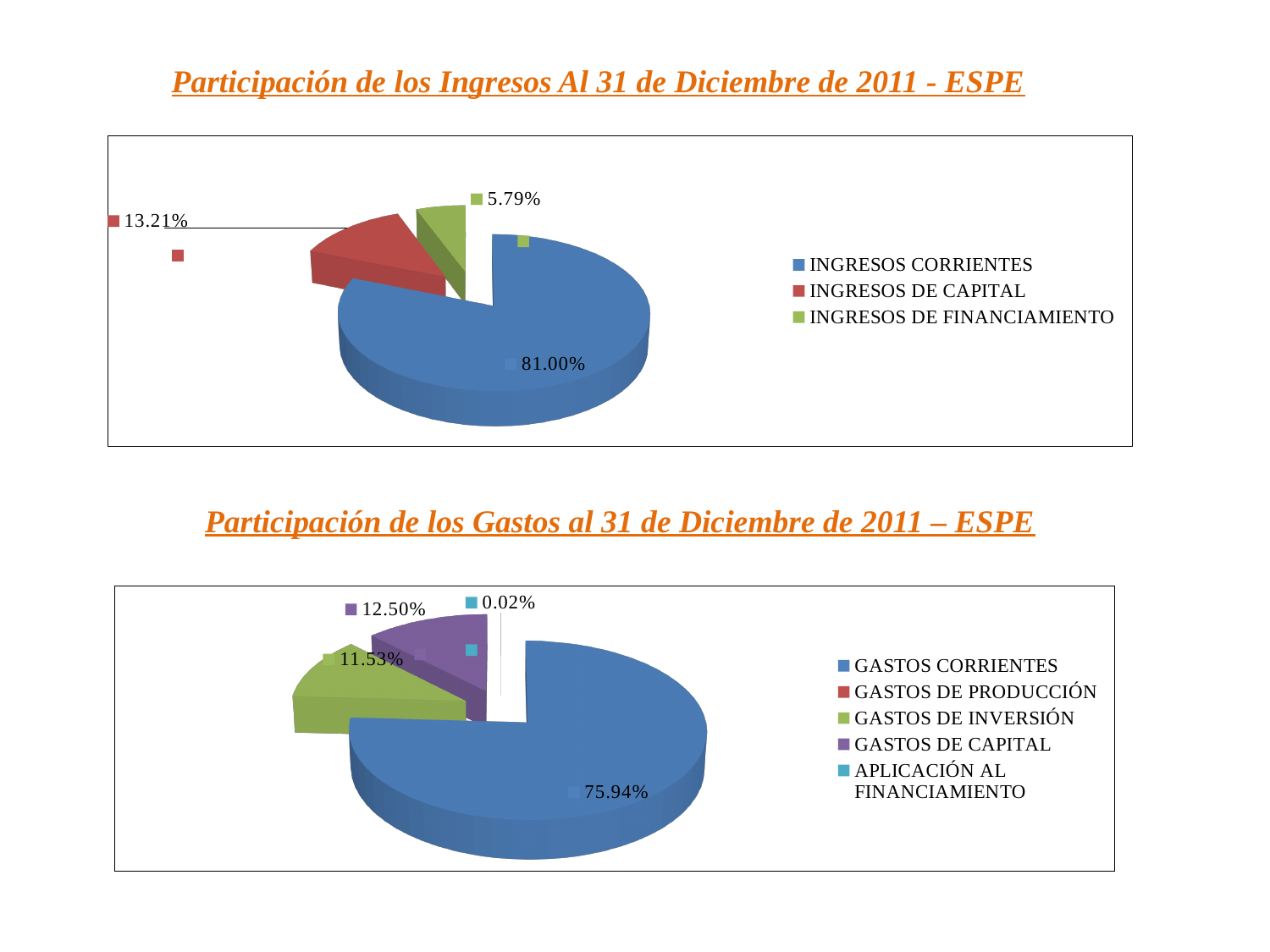
In the chart titled 'Participación de los Ingresos Al 31 de Diciembre de 2011 - ESPE', what share does INGRESOS DE CAPITAL have? 13.21% In the bottom chart (Gastos), which is larger: GASTOS DE CAPITAL or GASTOS DE INVERSIÓN? GASTOS DE CAPITAL In the chart titled 'Participación de los Gastos al 31 de Diciembre de 2011 – ESPE', what share does GASTOS CORRIENTES have? 75.94% In the chart titled 'Participación de los Gastos al 31 de Diciembre de 2011 – ESPE', what share does APLICACIÓN AL FINANCIAMIENTO have? 0.02% What kind of chart is the chart titled 'Participación de los Gastos al 31 de Diciembre de 2011 – ESPE'? Pie chart In the chart titled 'Participación de los Gastos al 31 de Diciembre de 2011 – ESPE', what share does GASTOS DE CAPITAL have? 12.50% How many categories does the legend of the top chart (Ingresos) list? 3 In the top chart (Ingresos), what is the difference between the shares of INGRESOS DE CAPITAL and INGRESOS DE FINANCIAMIENTO? 7.42% In the top chart (Ingresos), which category has the smallest share? INGRESOS DE FINANCIAMIENTO In the chart titled 'Participación de los Ingresos Al 31 de Diciembre de 2011 - ESPE', what share does INGRESOS CORRIENTES have? 81.00% How many categories does the legend of the bottom chart (Gastos) list? 5 In the chart titled 'Participación de los Ingresos Al 31 de Diciembre de 2011 - ESPE', what share does INGRESOS DE FINANCIAMIENTO have? 5.79%